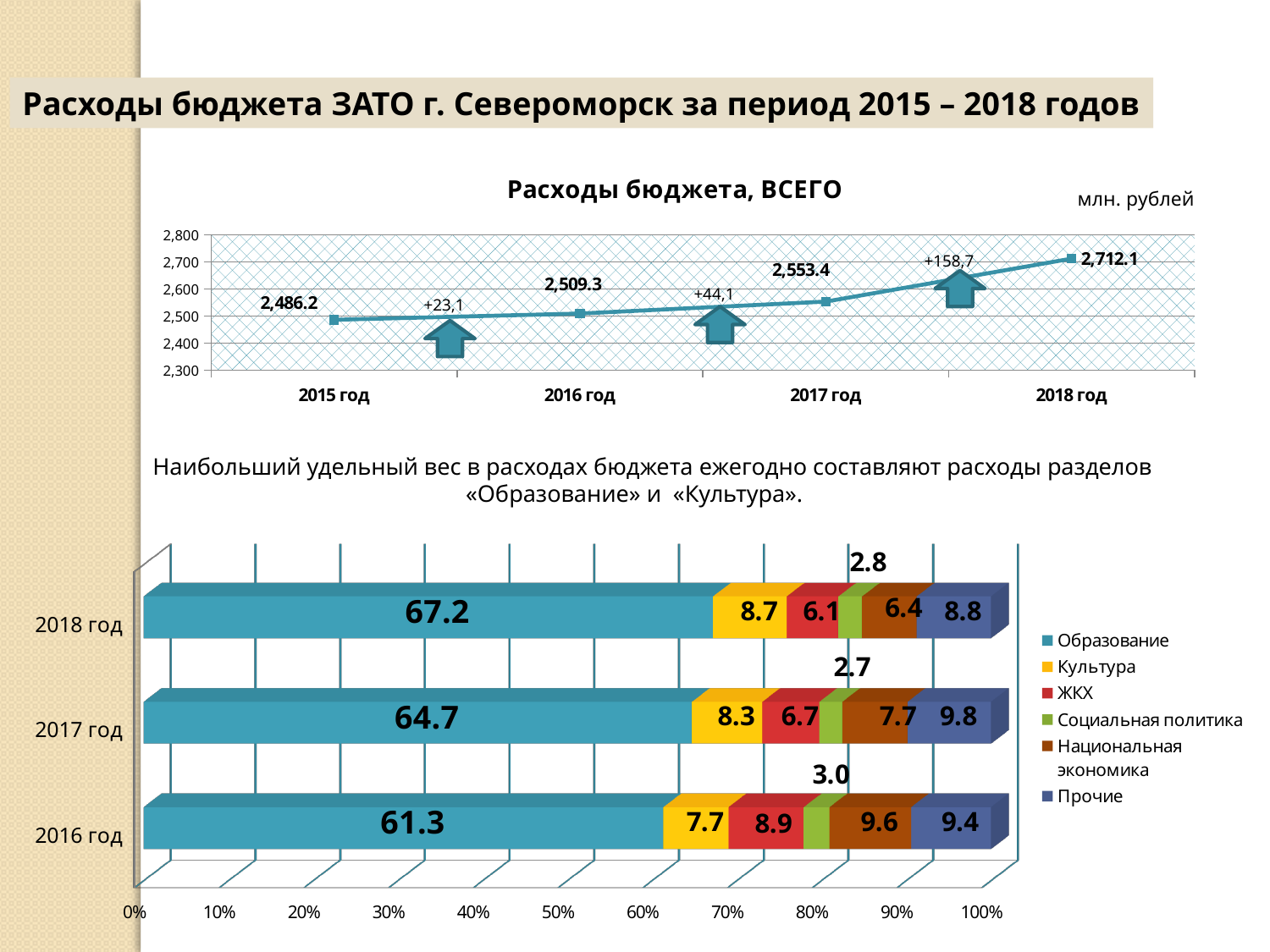
In the stacked bar chart at the bottom of the slide, which year has the lowest value for Образование? 2016 год In the chart titled "Расходы бюджета, ВСЕГО", do the values rise or fall from 2015 год to 2018 год? rise In the chart titled "Расходы бюджета, ВСЕГО", what is the value for 2018 год? 2,712.1 In the stacked bar chart at the bottom of the slide, is the value for ЖКХ larger in 2016 год or in 2018 год? 2016 год What kind of chart is the chart titled "Расходы бюджета, ВСЕГО"? line chart In the chart titled "Расходы бюджета, ВСЕГО", what is the difference between the values for 2017 год and 2016 год? 44.1 In the stacked bar chart at the bottom of the slide, what is the difference between the Культура values for 2018 год and 2017 год? 0.4 In the stacked bar chart at the bottom of the slide, what is the value for Образование in 2018 год? 67.2 How many series does the legend of the stacked bar chart at the bottom of the slide list? 6 In the chart titled "Расходы бюджета, ВСЕГО", which year has the highest value? 2018 год In the stacked bar chart at the bottom of the slide, what is the value for Национальная экономика in 2016 год? 9.6 In the chart titled "Расходы бюджета, ВСЕГО", what is the value for 2015 год? 2,486.2